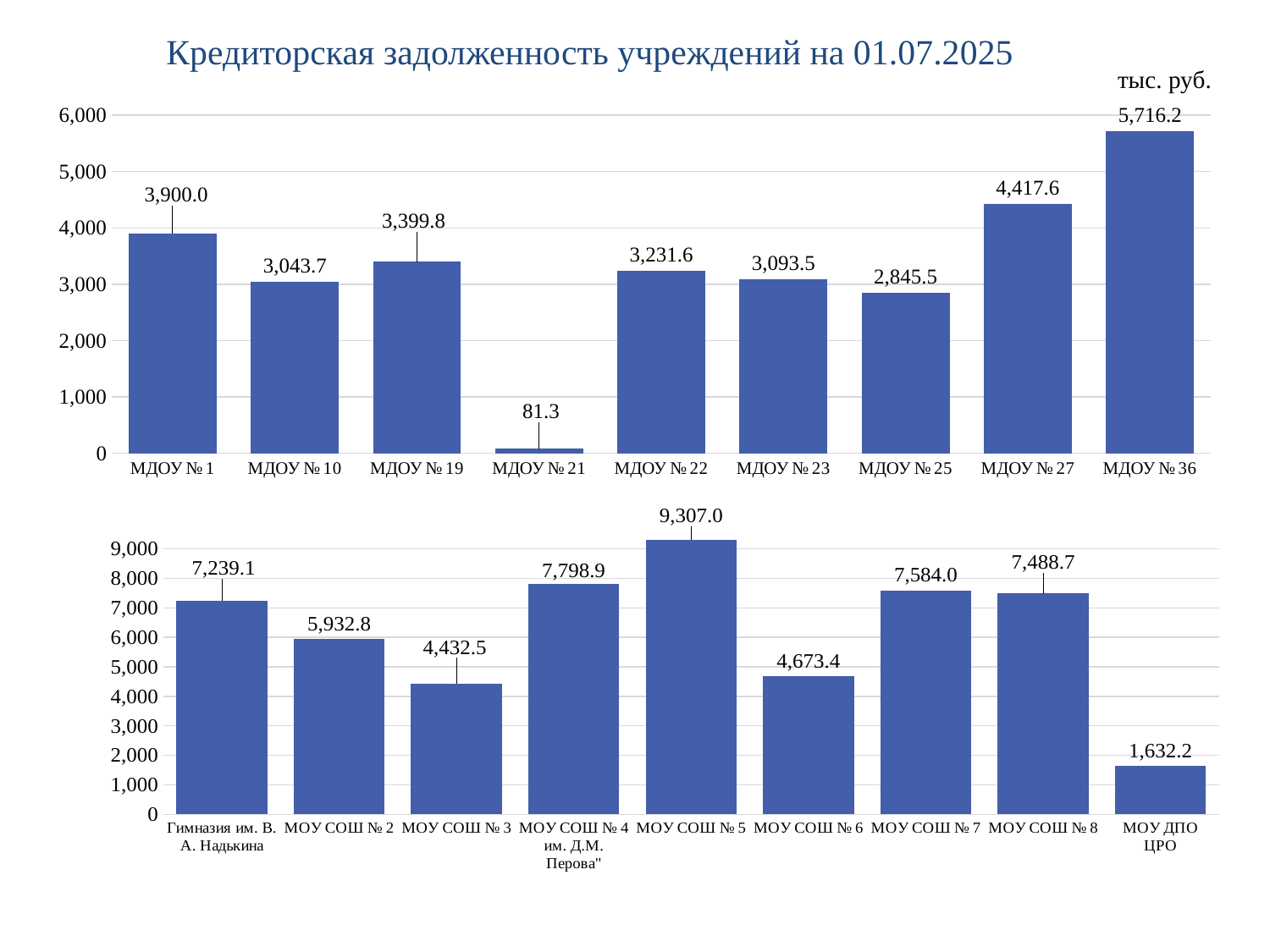
In the top chart, which institution has the lowest value? МДОУ № 21 What type of chart is the bottom chart? Bar chart In the bottom chart, which institution has the lowest value? МОУ ДПО ЦРО In the top chart, which institution has the highest value? МДОУ № 36 In the bottom chart, what is the value for МОУ СОШ № 6? 4,673.4 In the top chart, how many institutions are shown? 9 In the bottom chart, what is the difference between the values for МОУ СОШ № 5 and МОУ ДПО ЦРО? 7,674.8 In the top chart, what is the value for МДОУ № 27? 4,417.6 In the top chart, what is the difference between the values for МДОУ № 36 and МДОУ № 21? 5,634.9 In the top chart, what is the value for МДОУ № 21? 81.3 In the bottom chart, which is larger: the value for МОУ СОШ № 7 or МОУ СОШ № 8? МОУ СОШ № 7 In the bottom chart, which institution has the highest value? МОУ СОШ № 5